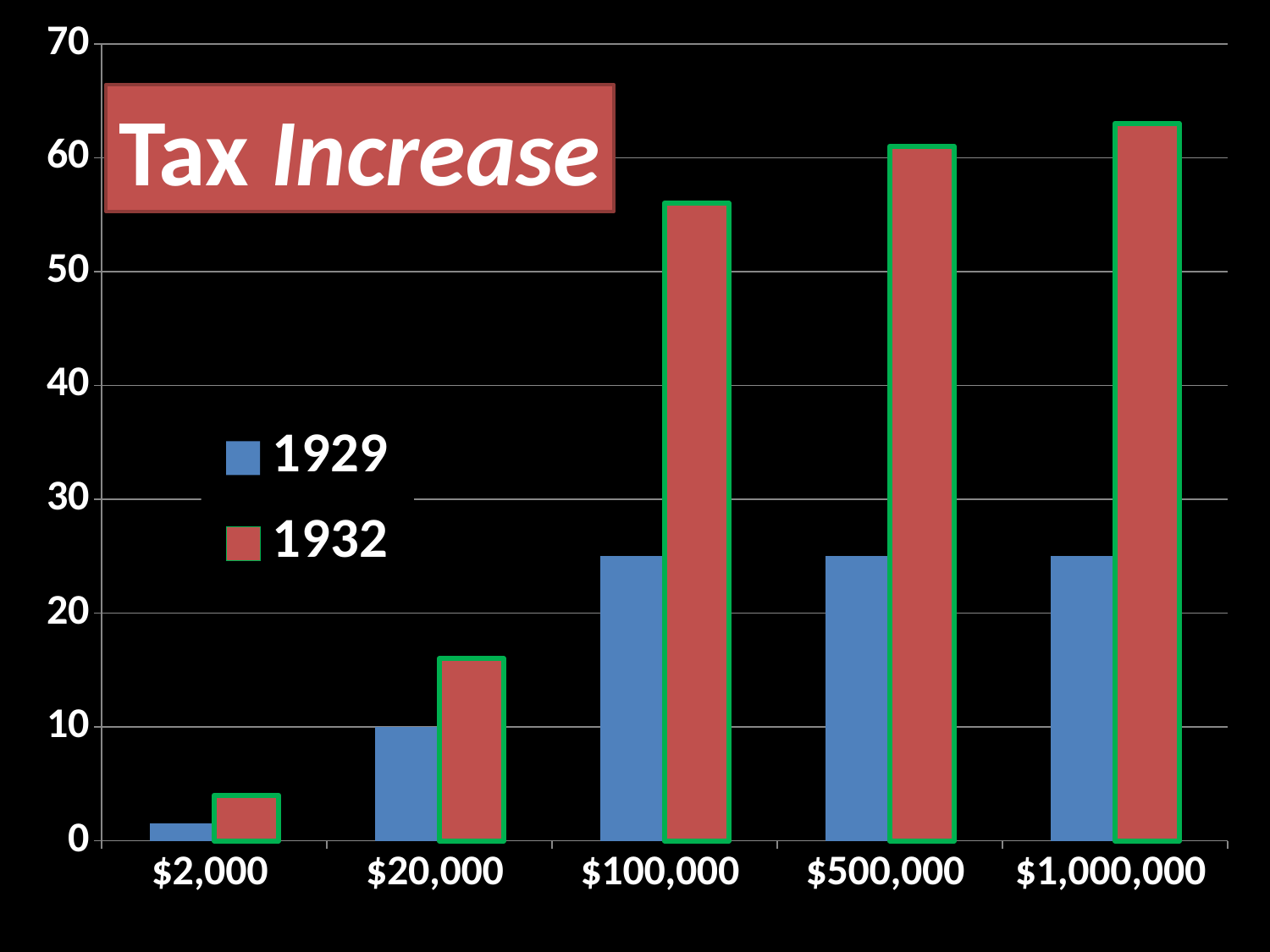
What kind of chart is shown on the slide? bar chart Is the 1932 value for $100,000 greater or less than 50? greater Which income category has the lowest value for 1932? $2,000 How many series does the legend list? 2 How many income categories are shown on the x axis? 5 Is the 1932 value for $2,000 greater or less than 10? less What is the title of the chart? Tax Increase Is the 1932 value for $1,000,000 greater or less than 60? greater For the $100,000 category, which series has the larger value, 1929 or 1932? 1932 Which income category has the highest value for 1932? $1,000,000 Do the 1932 values rise or fall as income increases along the x axis? rise